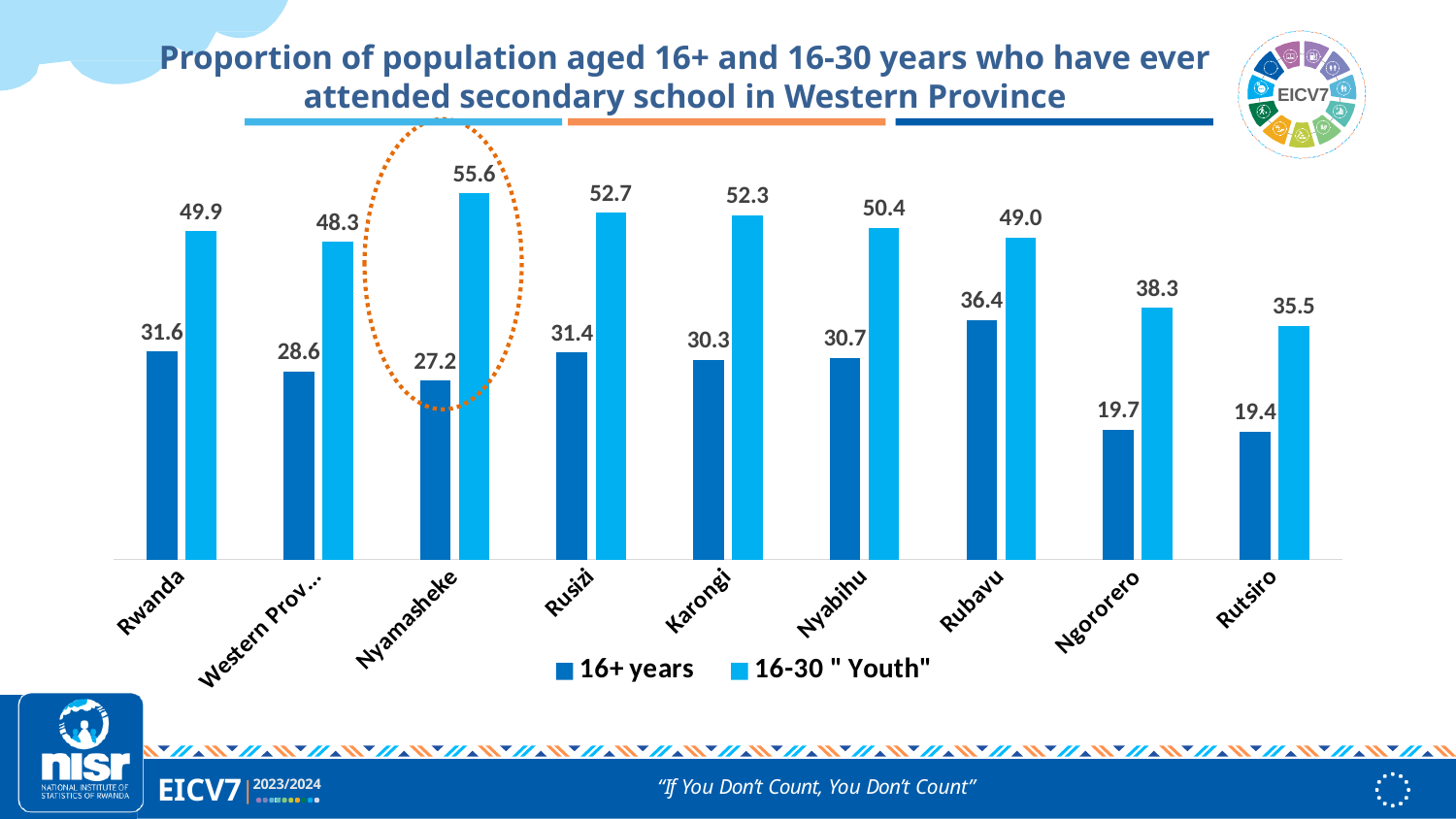
What kind of chart is shown on the slide? Bar chart Which category is highlighted with a dotted orange oval on the chart? Nyamasheke What is the value for Nyamasheke in the 16-30 "Youth" series? 55.6 How many series does the legend list? 2 How many categories are shown on the x axis? 9 What is the value for Rutsiro in the 16-30 "Youth" series? 35.5 Which category has the lowest value in the 16+ years series? Rutsiro Which category has the highest value in the 16-30 "Youth" series? Nyamasheke What is the value for Rubavu in the 16+ years series? 36.4 What is the difference between the 16+ years values for Ngororero and Rutsiro? 0.3 What is the difference between the 16-30 "Youth" value and the 16+ years value for Nyamasheke? 28.4 Which is larger: the 16+ years value for Rwanda or the 16+ years value for Rusizi? Rwanda